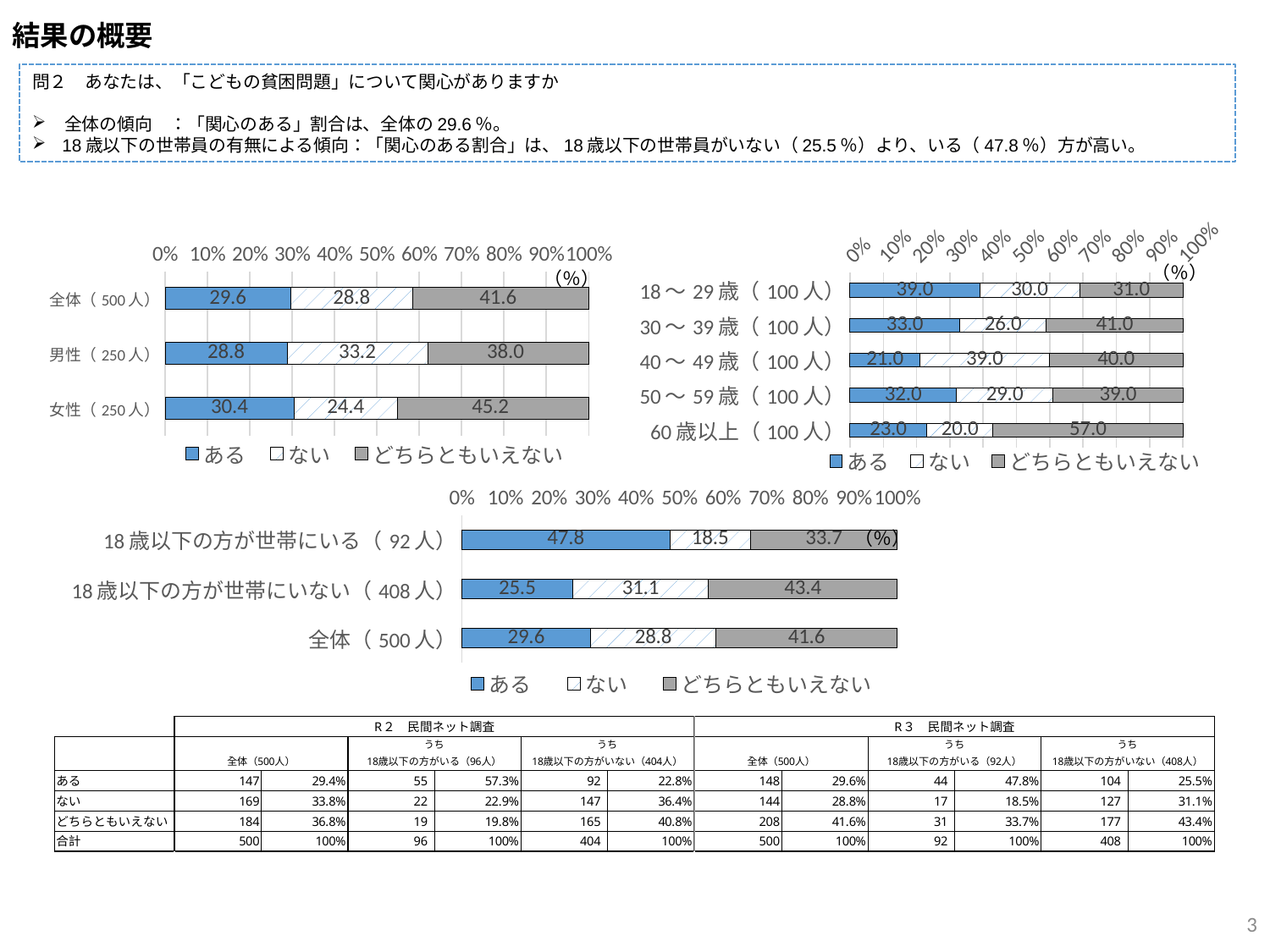
In the top-right chart, what is the value of どちらともいえない for 60歳以上（100人）? 57.0 In the top-right chart, which age group has the lowest value for ない? 60歳以上（100人） In the bottom chart, what is the value of ある for 18歳以下の方が世帯にいる（92人）? 47.8 What type of chart is the top-right chart? Stacked bar chart In the bottom chart, which is larger: the ない value for 18歳以下の方が世帯にいる（92人） or for 18歳以下の方が世帯にいない（408人）? 18歳以下の方が世帯にいない（408人） In the top-left chart, what is the value of ある for 全体（500人）? 29.6 In the bottom chart, what is the difference between the ある values for 18歳以下の方が世帯にいる（92人） and 18歳以下の方が世帯にいない（408人）? 22.3 In the top-left chart, what is the value of どちらともいえない for 女性（250人）? 45.2 In the top-right chart, which age group has the highest value for ある? 18～29歳（100人） How many series does the legend of the bottom chart list? 3 In the top-right chart, how many age groups are shown? 5 In the top-left chart, which category has the highest value for ない? 男性（250人）